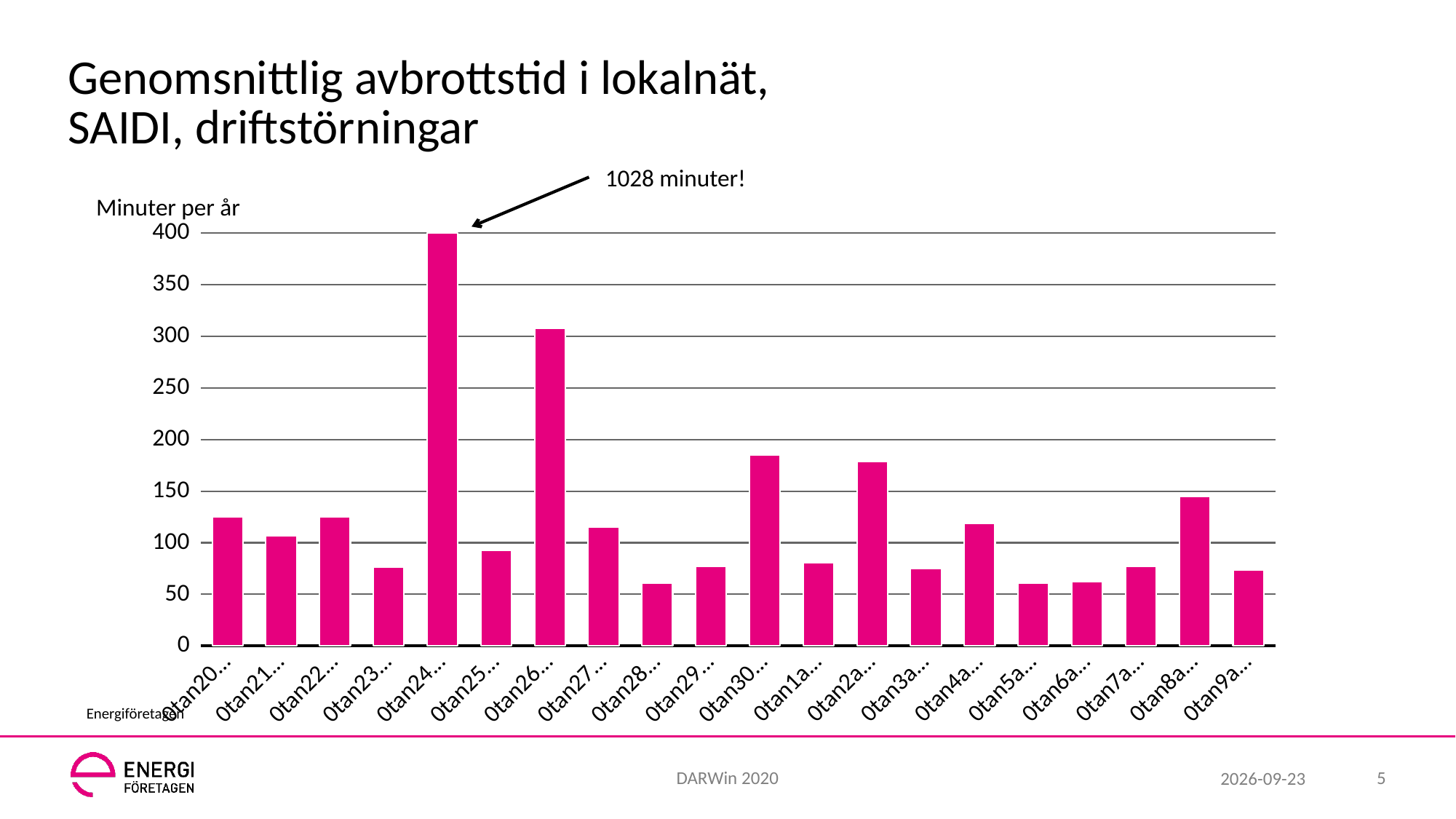
Which category has the highest bar in the chart? 0tan24... Is the value for 0tan28... greater or less than 100? less Is the value for 0tan8a... greater or less than 100? greater What kind of chart is shown on the slide? bar chart According to the annotation, how many minutes does the tallest bar (0tan24...) represent? 1028 minuter Is the value for 0tan26... greater or less than 250? greater Which is larger, the value for 0tan26... or the value for 0tan30...? 0tan26... What is the label on the vertical axis of the chart? Minuter per år What is the title of the slide containing the chart? Genomsnittlig avbrottstid i lokalnät, SAIDI, driftstörningar Which is larger, the value for 0tan2a... or the value for 0tan4a...? 0tan2a... How many bars (categories) are plotted in the chart? 20